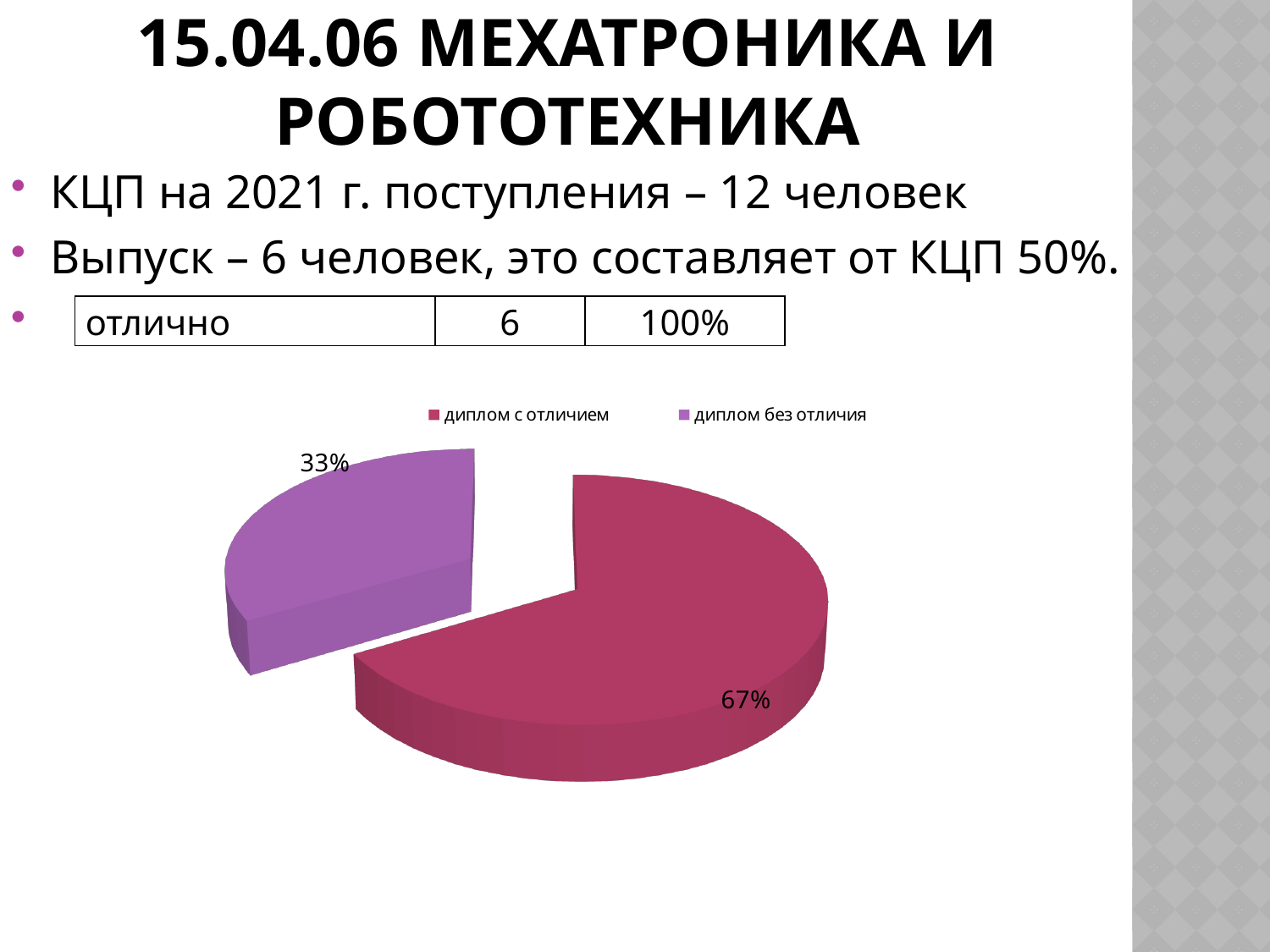
Which slice of the pie is the largest? диплом с отличием What colour is the "диплом без отличия" slice? purple What share of the pie does "диплом без отличия" represent? 33% What is the difference in percentage points between the "диплом с отличием" and "диплом без отличия" slices? 34 percentage points Which is larger: the share for "диплом с отличием" or for "диплом без отличия"? диплом с отличием Is the share for "диплом без отличия" greater or less than 50%? less What share of the pie does "диплом с отличием" represent? 67% How many slices does the pie chart have? 2 How many entries does the legend list? 2 Which slice of the pie is the smallest? диплом без отличия What kind of chart is shown on the slide? pie chart What colour is the "диплом с отличием" slice? crimson